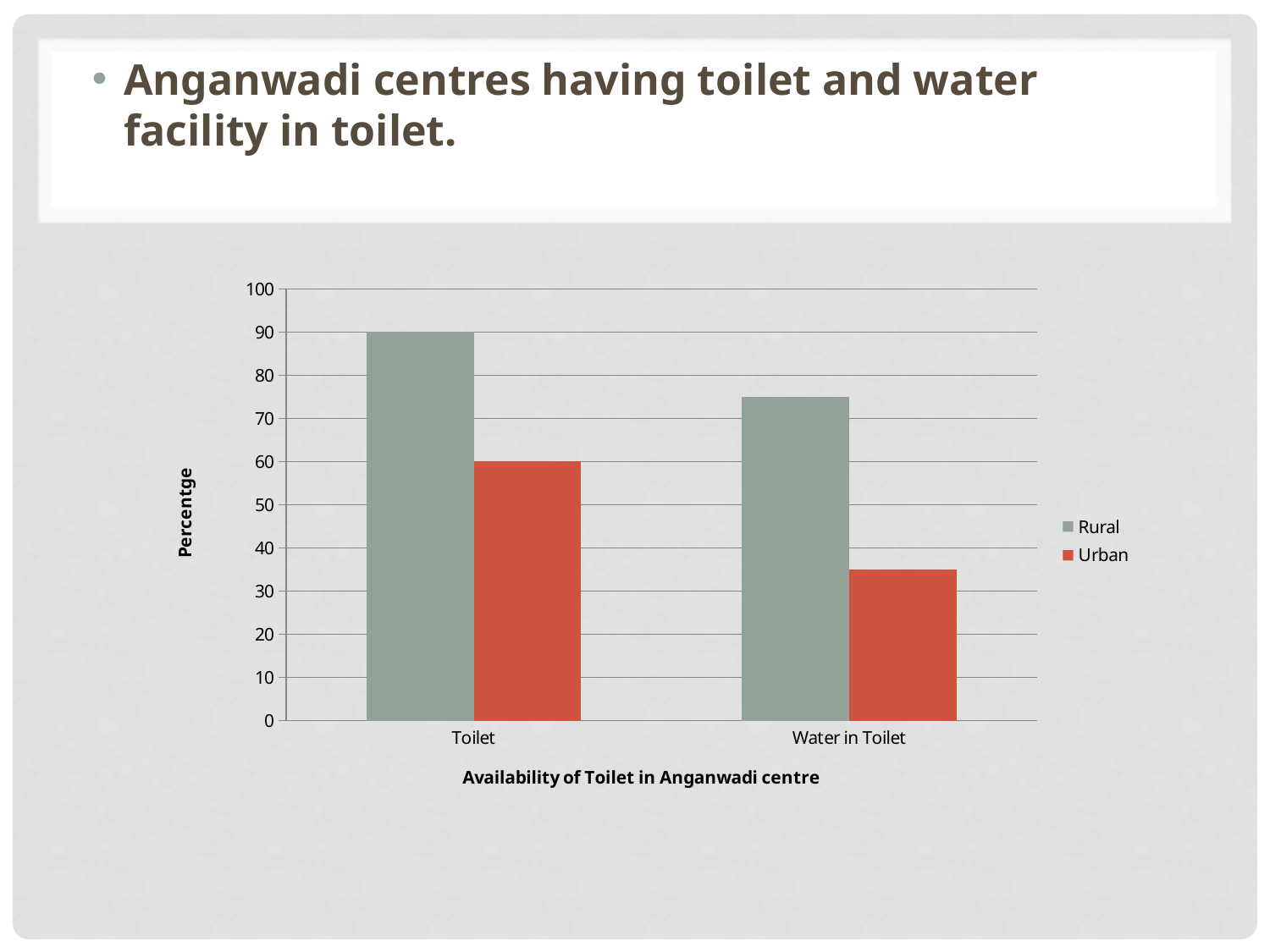
Which bar is the tallest in the chart? Rural, Toilet Is the Urban value for Water in Toilet greater or less than 40? less What type of chart is shown on the slide? bar chart Which series has the higher value for Water in Toilet, Rural or Urban? Rural How many categories are shown on the x axis? 2 Is the Rural value for Water in Toilet greater or less than 70? greater What is the Rural value for Toilet? 90 What is the Urban value for Toilet? 60 How many series does the legend list? 2 What is the label of the y axis? Percentge Which bar is the shortest in the chart? Urban, Water in Toilet What is the difference between the Rural and Urban values for Toilet? 30